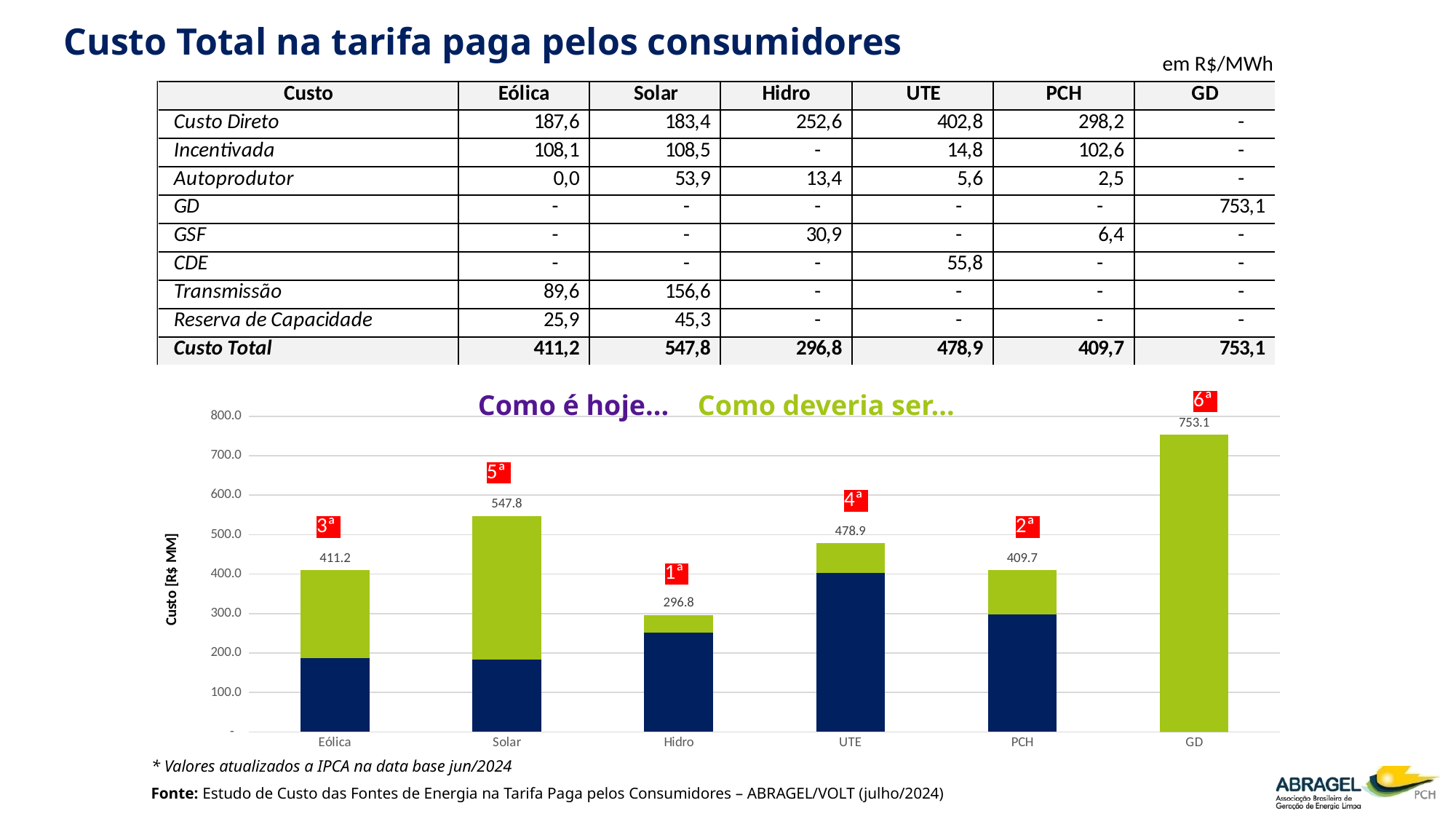
What is the label of the y axis of the chart? Custo [R$ MM] What is the total value labelled above the GD bar? 753.1 Which category has the lowest total in the chart? Hidro How many categories are shown on the x axis of the chart? 6 Which has a larger total, UTE or PCH? UTE What ranking label is shown above the PCH bar? 2ª Which category has the highest total in the chart? GD What is the total value labelled above the Solar bar? 547.8 Is the total for Eólica greater or less than 500.0? less What kind of chart is shown on the slide? Stacked bar chart What is the difference between the total for GD and the total for Hidro? 456.3 What is the total value labelled above the Hidro bar? 296.8